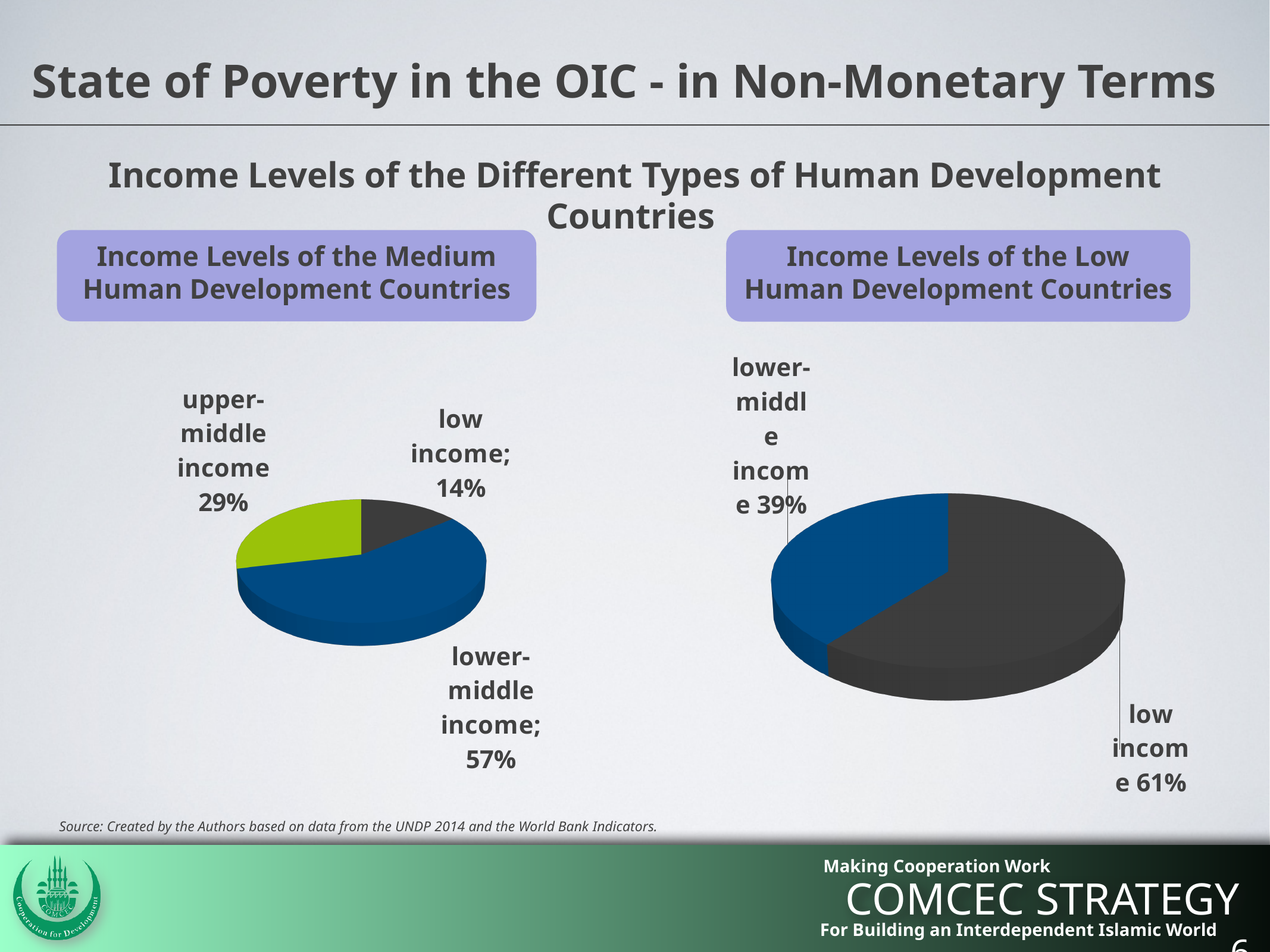
What kind of chart is the Income Levels of the Low Human Development Countries chart? pie chart In the Income Levels of the Medium Human Development Countries chart, which category has the smallest share? low income In the Income Levels of the Low Human Development Countries chart, what share is lower-middle income? 39% In the Income Levels of the Medium Human Development Countries chart, what share is low income? 14% In the Income Levels of the Low Human Development Countries chart, which category has the larger share? low income In the Income Levels of the Medium Human Development Countries chart, what share is lower-middle income? 57% In the Income Levels of the Low Human Development Countries chart, what share is low income? 61% In the Income Levels of the Medium Human Development Countries chart, what is the difference between the lower-middle income and upper-middle income shares? 28 percentage points In the Income Levels of the Low Human Development Countries chart, what is the difference between the low income and lower-middle income shares? 22 percentage points In the Income Levels of the Medium Human Development Countries chart, what share is upper-middle income? 29% In the Income Levels of the Medium Human Development Countries chart, which category has the largest share? lower-middle income How many categories does the Income Levels of the Medium Human Development Countries chart show? 3